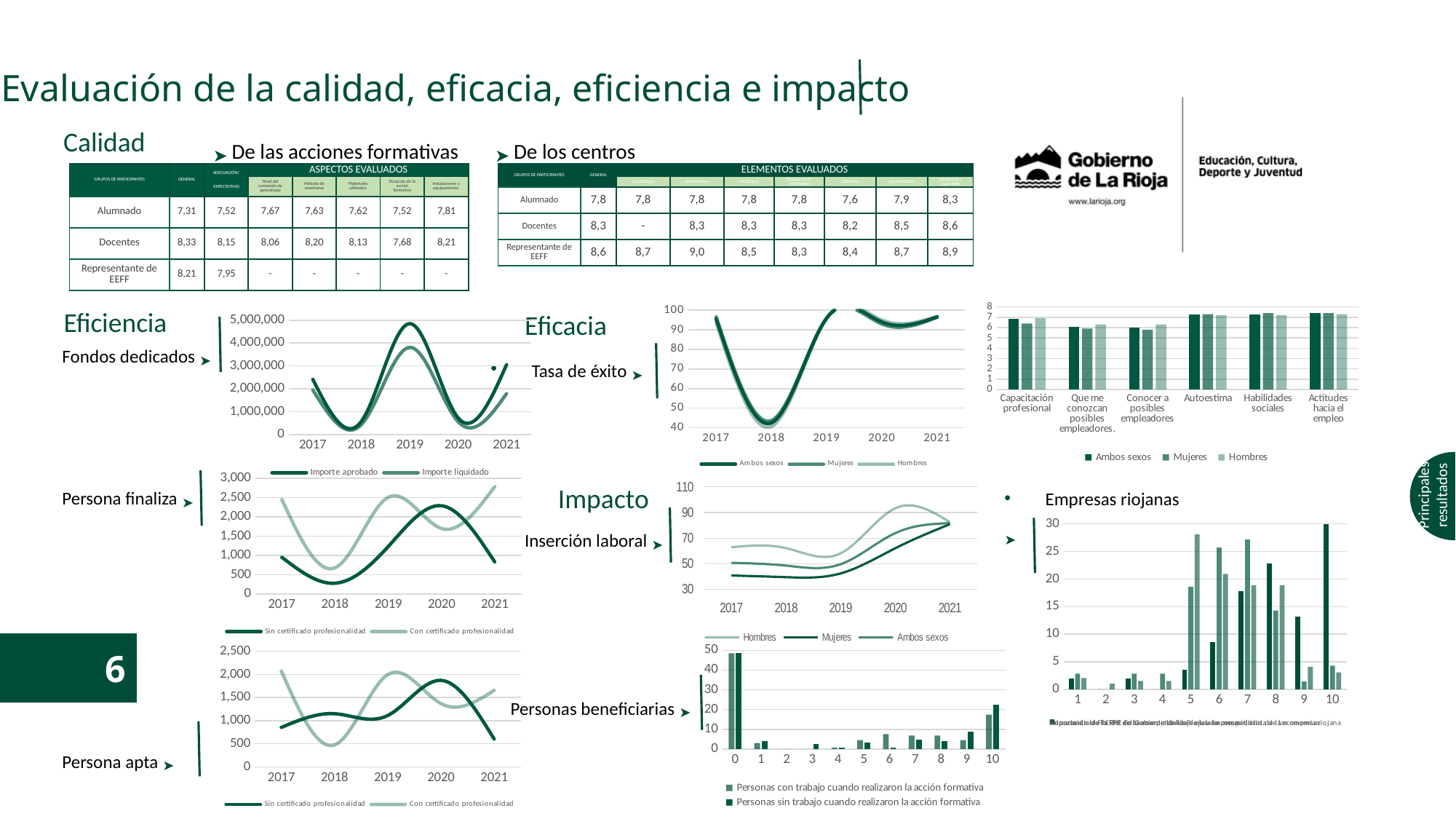
In the 'Tasa de éxito' chart, in which year is the value for Ambos sexos lowest? 2018 In the 'Persona finaliza' chart, which series has the larger value in 2019, Sin certificado profesionalidad or Con certificado profesionalidad? Con certificado profesionalidad In the 'Inserción laboral' chart, which series has the highest value in 2017? Hombres How many categories are shown on the x axis of the 'Empresas riojanas' bar chart? 10 How many categories are shown on the x axis of the bar chart with categories such as 'Capacitación profesional' and 'Autoestima'? 6 In the 'Fondos dedicados' chart, in which year does Importe aprobado reach its highest value? 2019 How many series does the legend of the 'Fondos dedicados' chart list? 2 In the 'Persona apta' chart, is the value of Sin certificado profesionalidad in 2021 greater or less than 1,000? less What kind of chart is the 'Fondos dedicados' chart? line chart In the 'Personas beneficiarias' bar chart, which category on the x axis has the tallest bars? 0 In the 'Fondos dedicados' chart, is the value of Importe aprobado in 2019 greater or less than 4,000,000? greater In the 'Tasa de éxito' chart, is the value for Ambos sexos in 2018 greater or less than 50? less